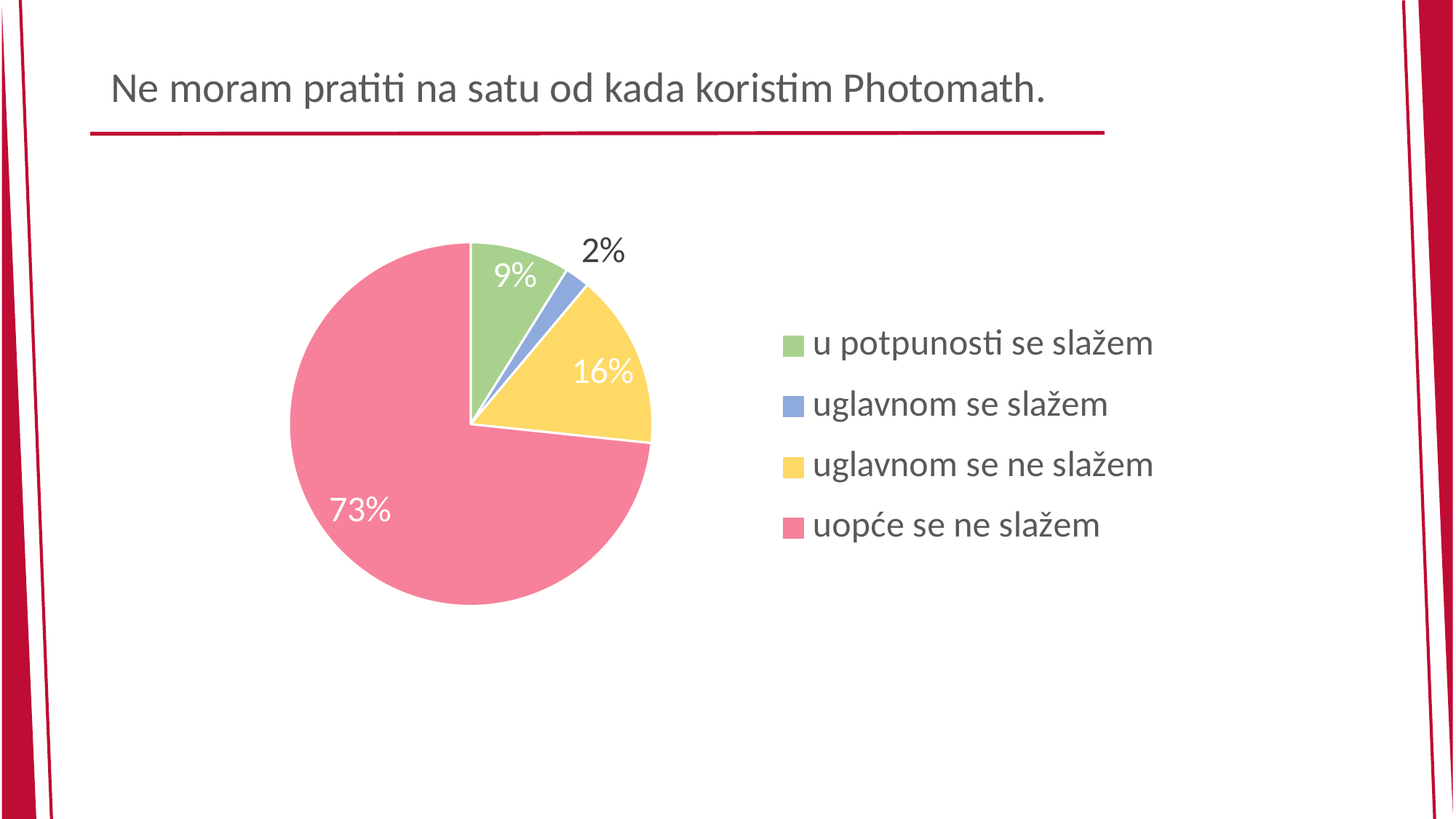
What is the difference in percentage points between "uopće se ne slažem" and "uglavnom se ne slažem"? 57 Which category has the smallest slice of the pie? uglavnom se slažem What share of the pie is labelled "uglavnom se ne slažem"? 16% What share of the pie is labelled "uopće se ne slažem"? 73% Which is larger: the slice for "u potpunosti se slažem" or the slice for "uglavnom se ne slažem"? uglavnom se ne slažem What colour is the slice for "uglavnom se ne slažem"? yellow What share of the pie is labelled "u potpunosti se slažem"? 9% How many slices does the pie chart have? 4 Which category has the largest slice of the pie? uopće se ne slažem What kind of chart is shown on the slide? pie chart What is the title of the slide containing the pie chart? Ne moram pratiti na satu od kada koristim Photomath.